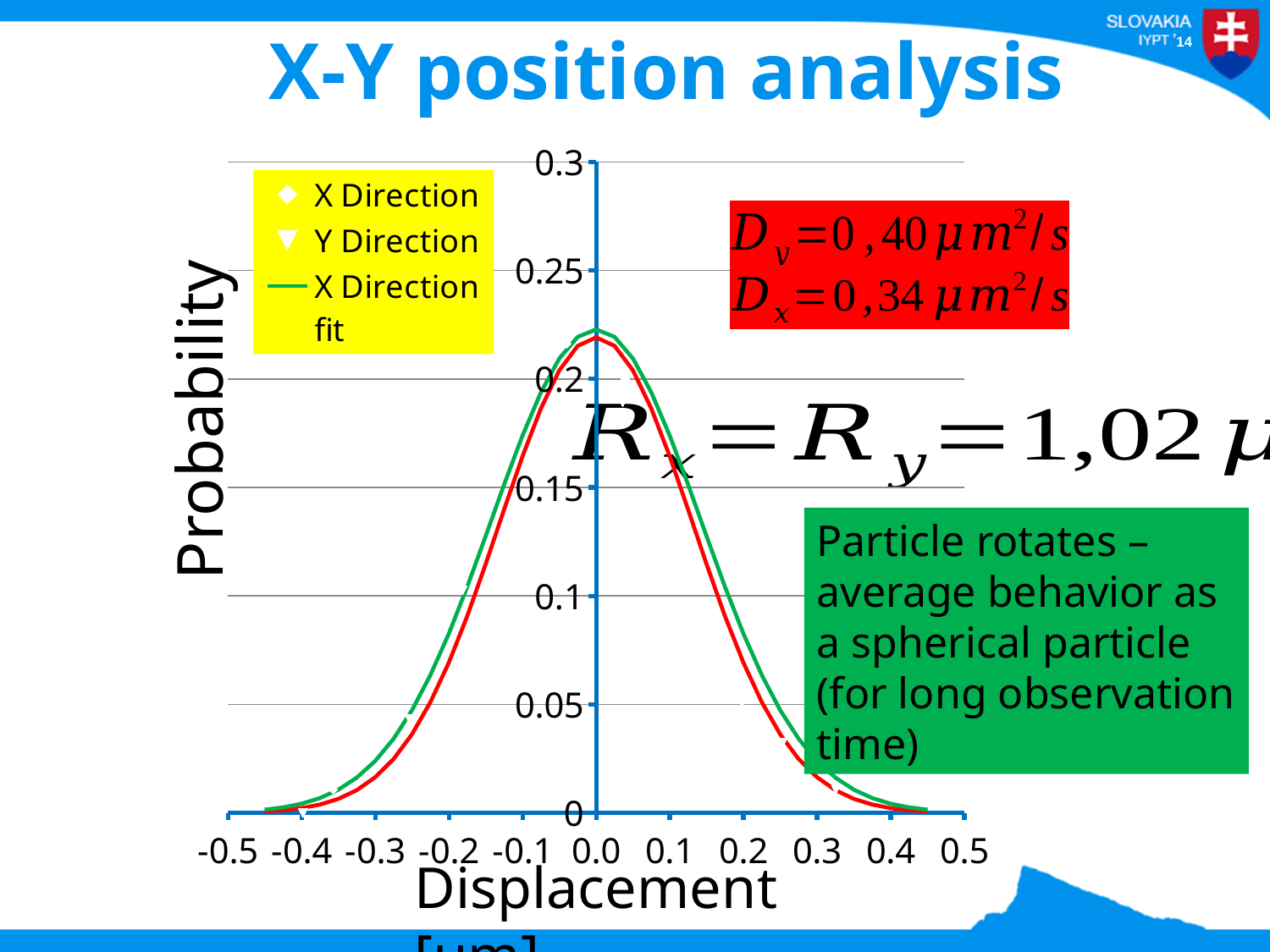
Is the peak value of the green curve greater or less than 0.2? greater Is the peak value of the red curve greater or less than 0.25? less Is the value of the red curve at displacement 0.3 greater or less than 0.1? less At which displacement value do the curves reach their peak? 0.0 What kind of chart is shown on the slide? line chart How many series does the chart legend list? 3 Do the curves rise or fall as displacement goes from 0.0 to 0.5? fall How many tick labels are shown on the x axis of the chart? 11 What is the label of the y axis of the chart? Probability What are the three entries in the chart legend? X Direction, Y Direction, X Direction fit